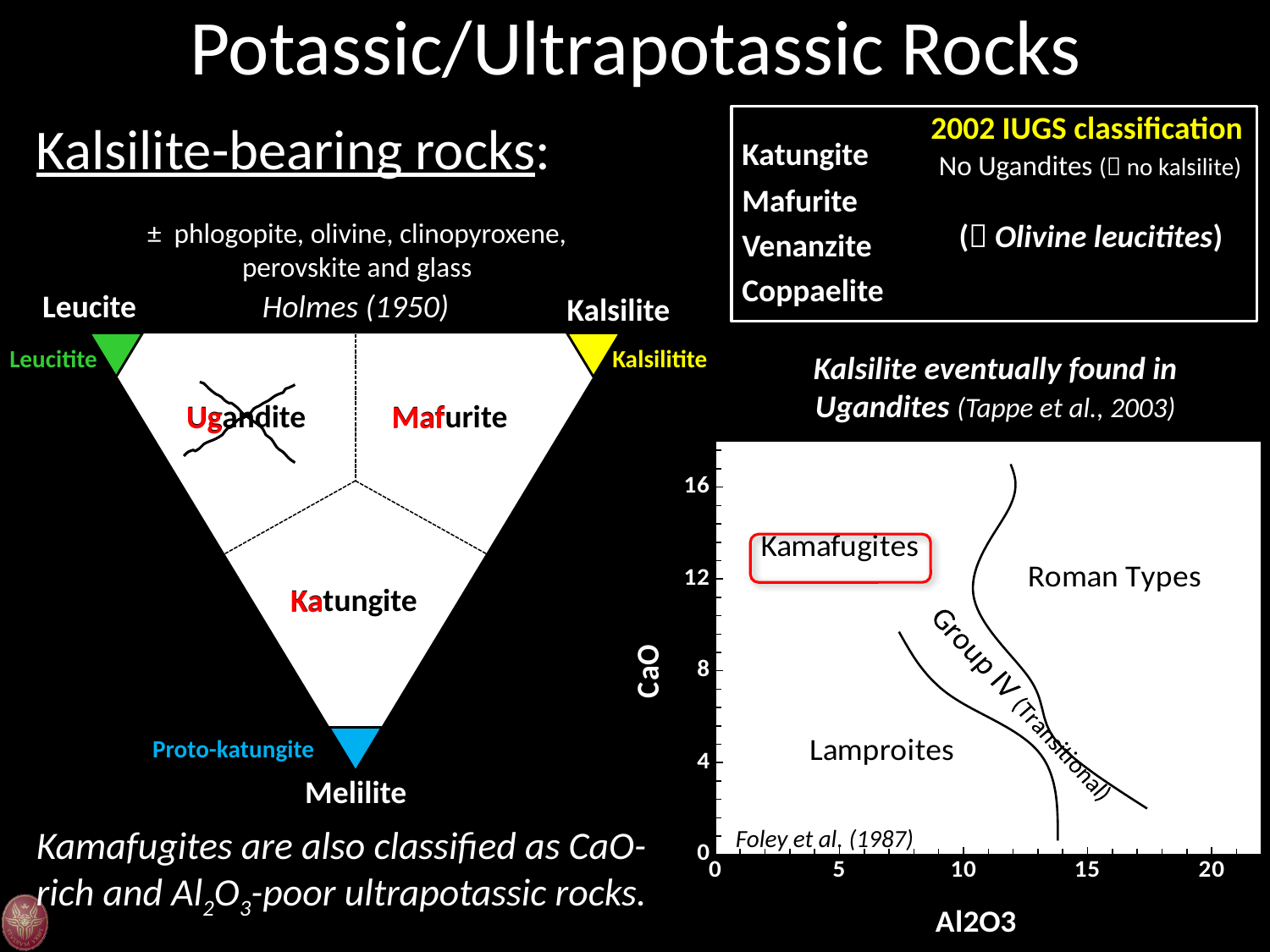
In the ternary diagram on the left, which mineral is at the bottom corner? Melilite In the ternary diagram on the left, which rock name is crossed out? Ugandite In the ternary diagram on the left, what colour is the Kalsilitite corner? Yellow In the CaO versus Al2O3 diagram on the right, what is the label of the x axis? Al2O3 In the CaO versus Al2O3 diagram on the right, which source is cited for the diagram? Foley et al. (1987) In the CaO versus Al2O3 diagram on the right, how many rock fields are labelled? 4 In the ternary diagram on the left, how many rock fields are labelled inside the triangle? 3 In the CaO versus Al2O3 diagram on the right, which field occupies the low-CaO region at the bottom left? Lamproites What kind of chart is the diagram on the left with Leucite, Kalsilite and Melilite at its corners? Ternary diagram In the CaO versus Al2O3 diagram on the right, what is the highest tick value shown on the x axis? 20 In the CaO versus Al2O3 diagram on the right, what is the highest tick value shown on the y axis? 16